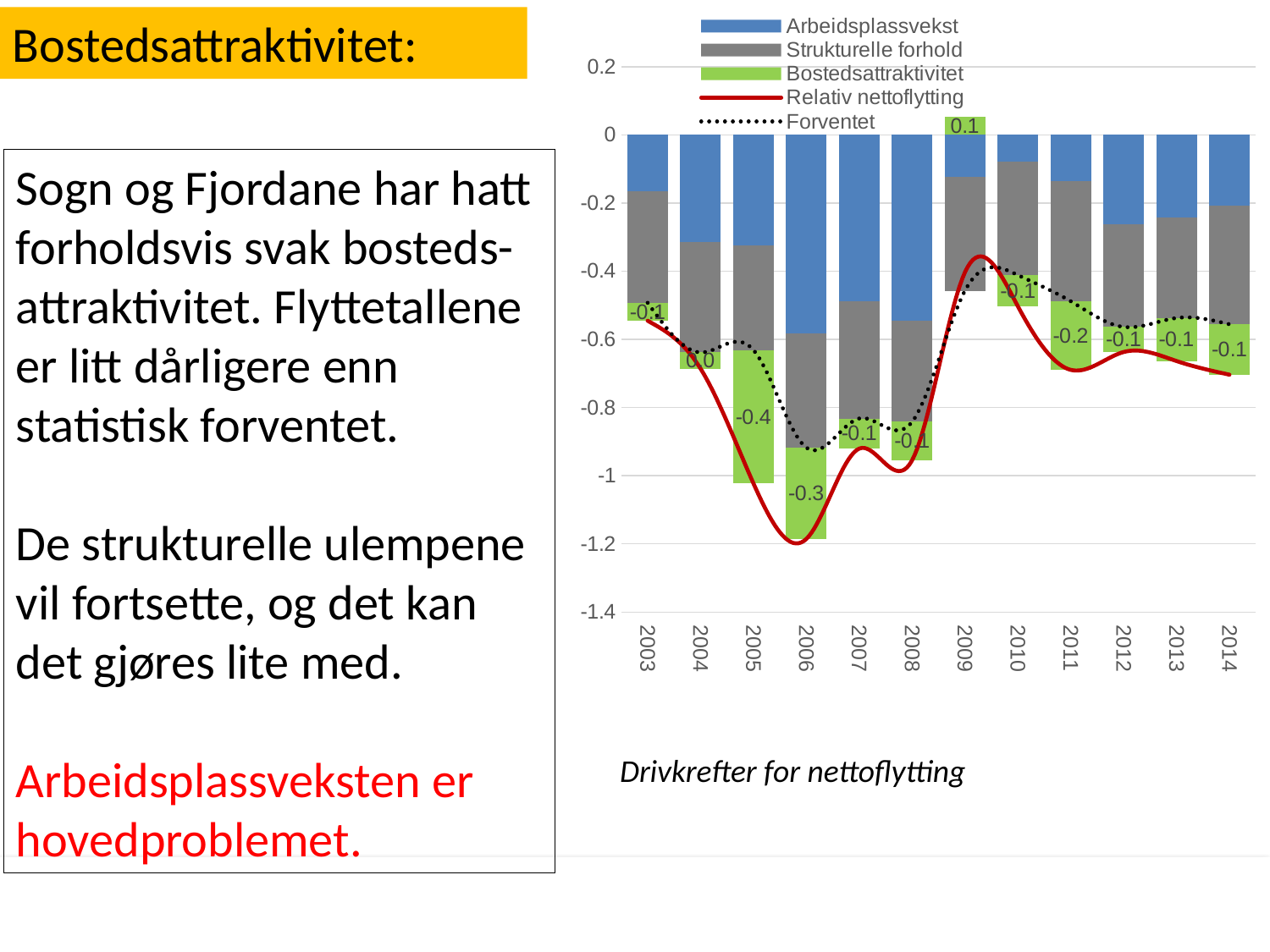
Which year has the larger Bostedsattraktivitet value, 2005 or 2009? 2009 What is the Bostedsattraktivitet value for 2005? -0.4 In which year is the Bostedsattraktivitet value highest? 2009 What caption is shown below the chart? Drivkrefter for nettoflytting Is the Relativ nettoflytting value for 2006 greater or less than -1? less What is the Bostedsattraktivitet value for 2009? 0.1 How many series does the chart legend list? 5 What kind of chart is shown on the slide? Bar chart with lines (stacked bars and line series) How many years are shown on the x axis of the chart? 12 In which year is the Bostedsattraktivitet value lowest? 2005 What is the Bostedsattraktivitet value for 2011? -0.2 What is the difference between the Bostedsattraktivitet values for 2005 and 2006? 0.1